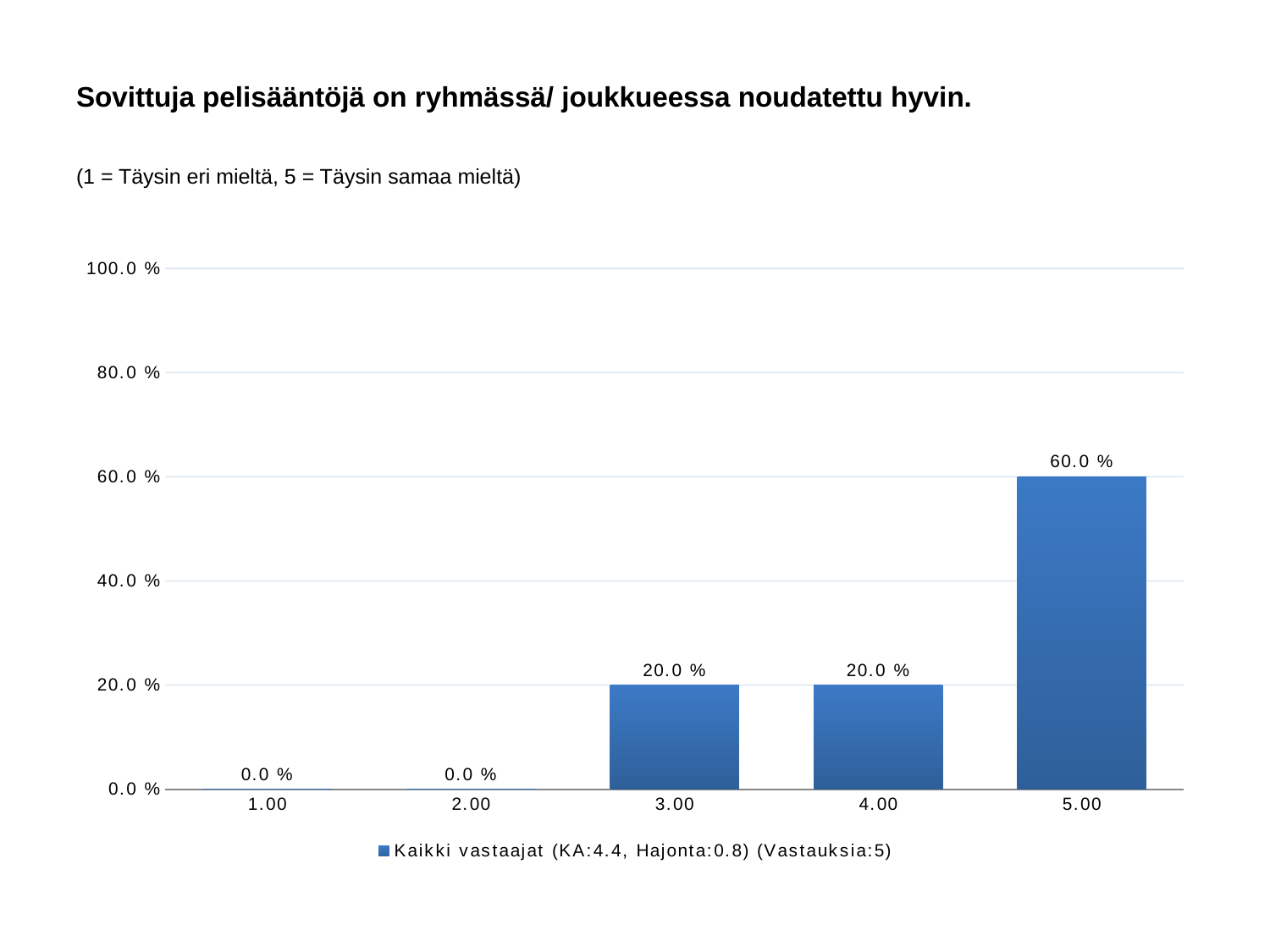
What is the legend entry for the series? Kaikki vastaajat (KA:4.4, Hajonta:0.8) (Vastauksia:5) What is the value for category 3.00? 20.0 % What is the title of the slide? Sovittuja pelisääntöjä on ryhmässä/ joukkueessa noudatettu hyvin. Which category has the highest value? 5.00 How many series does the legend list? 1 How many categories are shown on the x axis? 5 Is the value for 5.00 greater or less than 40.0 %? greater What kind of chart is shown? bar chart What is the difference between the values for 5.00 and 4.00? 40.0 % Which is larger, the value for 3.00 or the value for 5.00? 5.00 What is the value for category 5.00? 60.0 % What is the value for category 1.00? 0.0 %